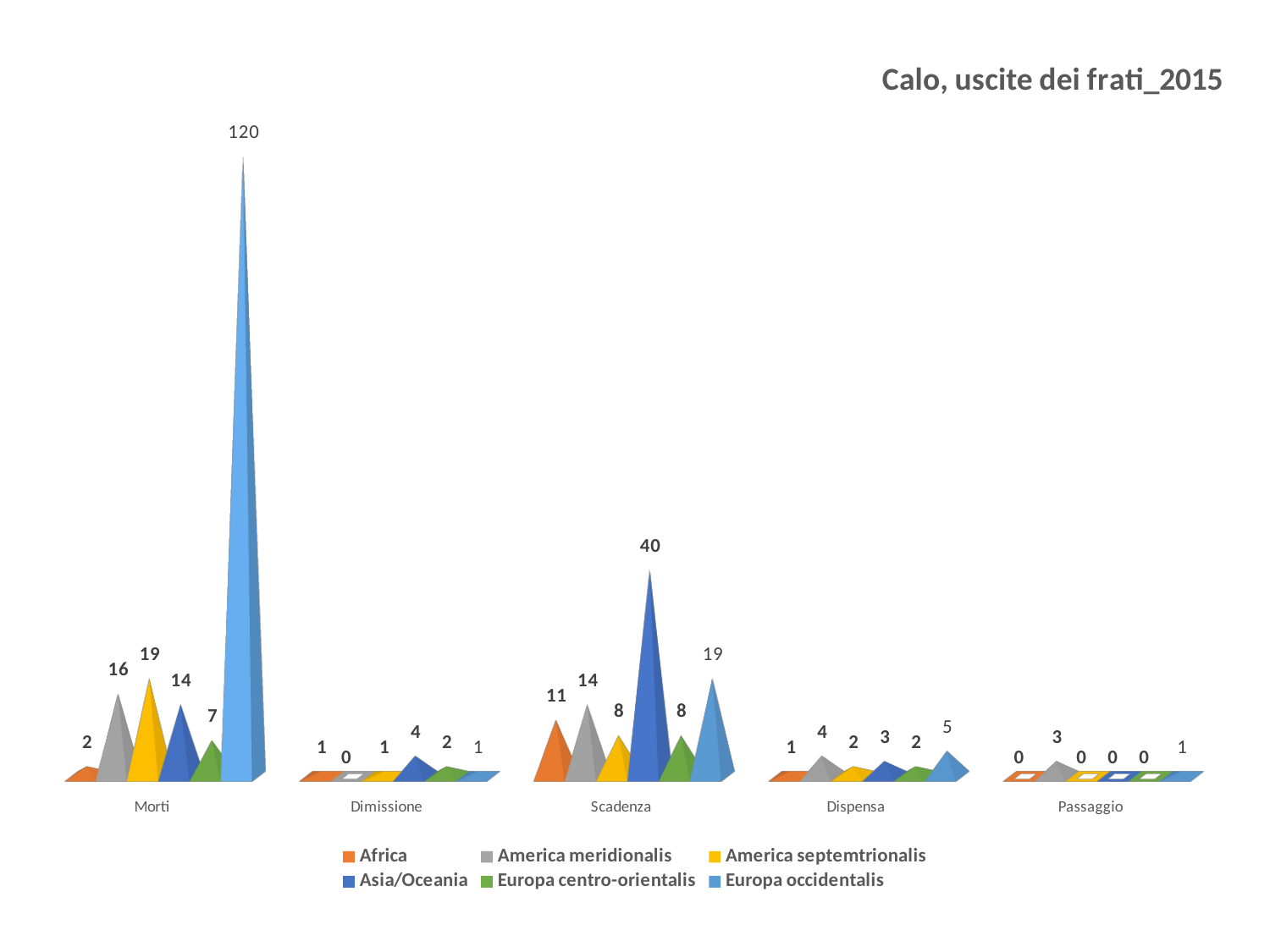
What is the value for Africa in the Scadenza category? 11 Which is larger in the Scadenza category: the value for America meridionalis or the value for Europa occidentalis? Europa occidentalis How many categories are shown on the x axis? 5 How many series does the legend list? 6 Which series has the highest value in the Dispensa category? Europa occidentalis Which series has the lowest value in the Morti category? Africa What is the title of the chart? Calo, uscite dei frati_2015 What is the value for Europa occidentalis in the Morti category? 120 What kind of chart is shown on the slide? Bar chart What is the value for Asia/Oceania in the Scadenza category? 40 What is the value for America meridionalis in the Passaggio category? 3 What is the difference between the Europa occidentalis value and the America septemtrionalis value in the Morti category? 101